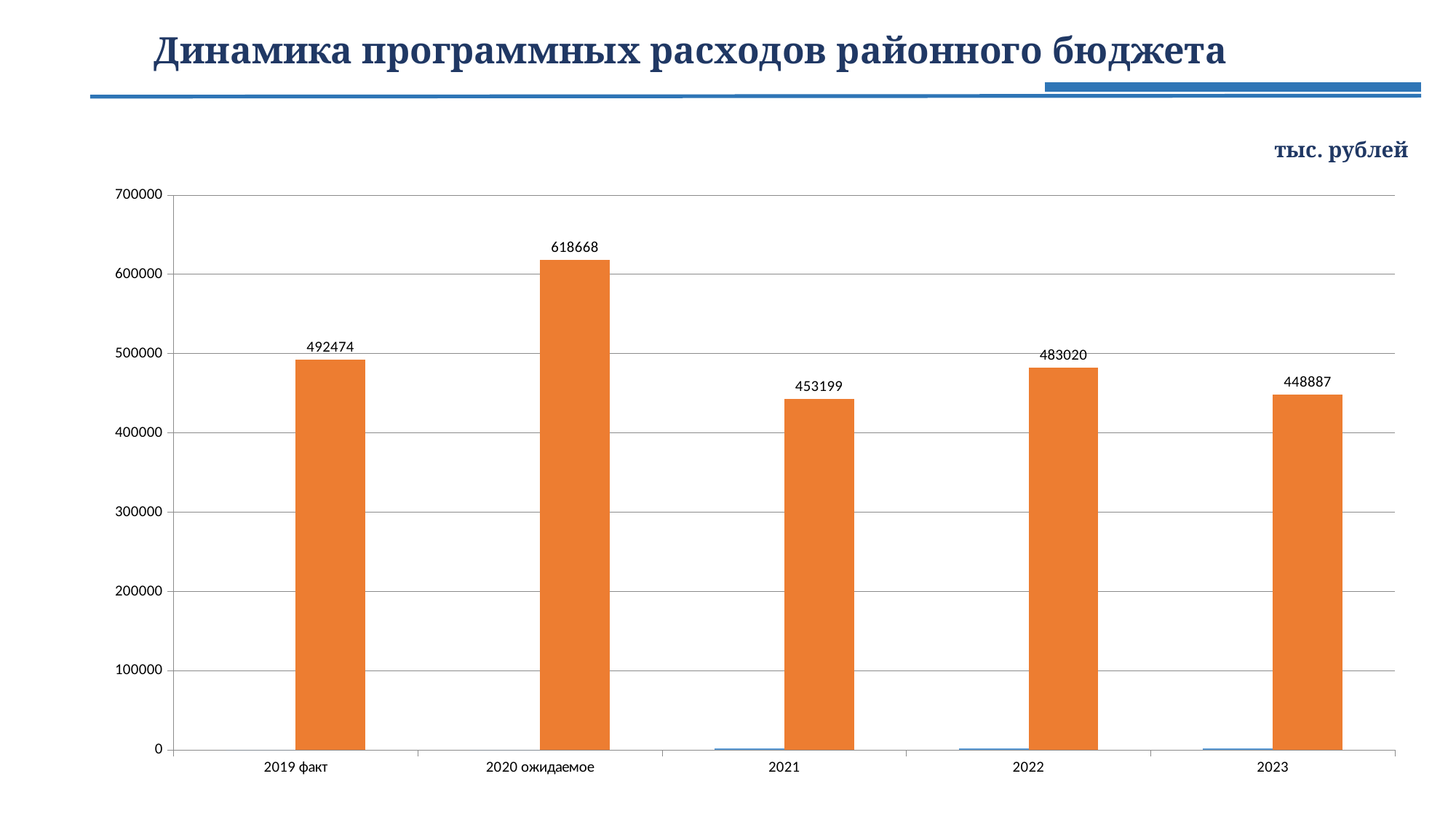
What is the value for 2021? 453199 What kind of chart is shown on the slide? bar chart Which category has the highest value? 2020 ожидаемое What unit is stated for the values on the chart? тыс. рублей What is the difference between the values for 2020 ожидаемое and 2019 факт? 126194 Which is larger, the value for 2022 or the value for 2021? 2022 What is the value for 2023? 448887 What is the value for 2019 факт? 492474 What is the difference between the values for 2022 and 2021? 29821 How many categories are shown on the x axis? 5 What is the value for 2020 ожидаемое? 618668